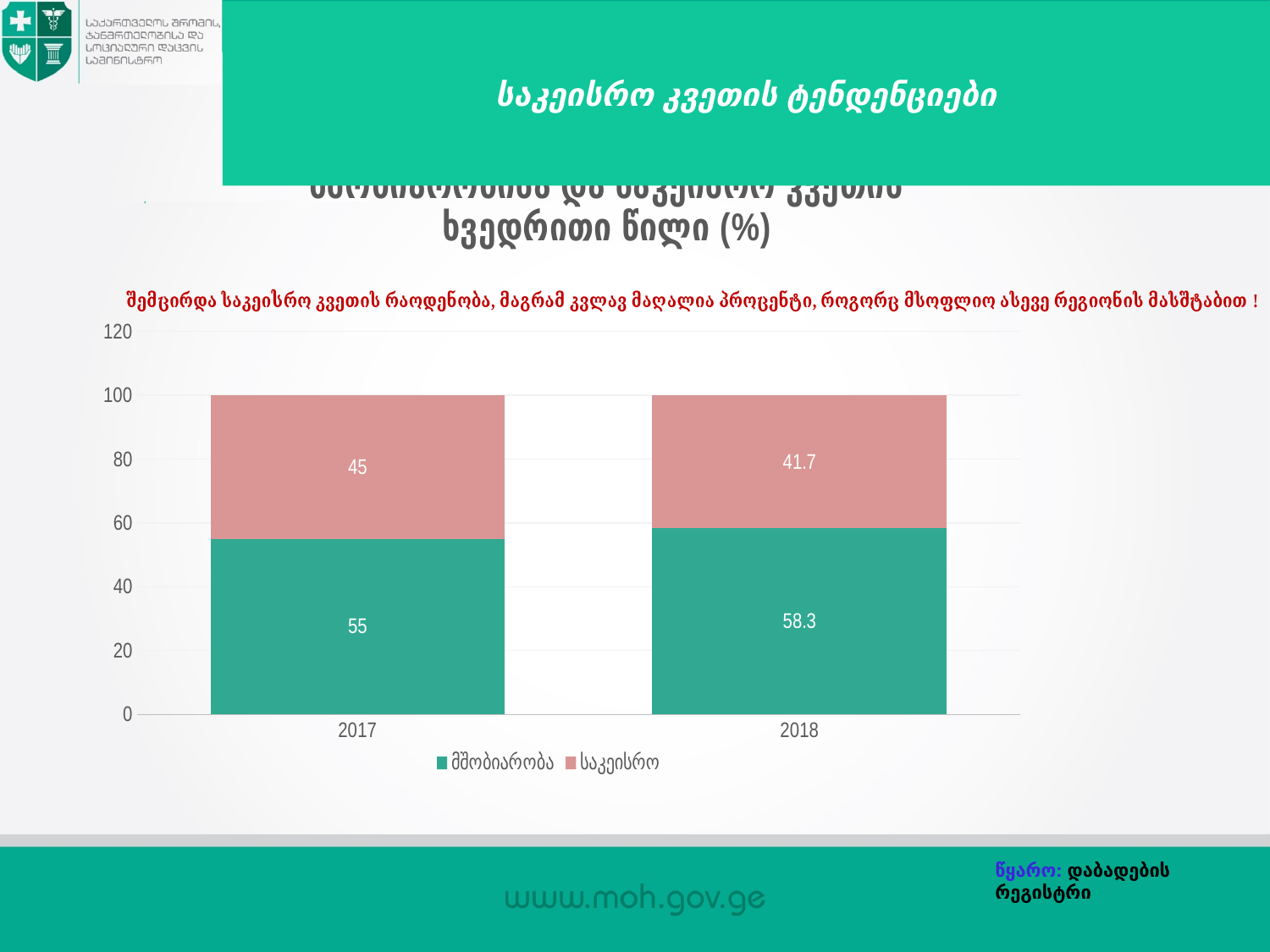
How many series does the legend list? 2 What kind of chart is shown on the slide? Stacked bar chart How many years are shown on the x axis? 2 In which year is the საკეისრო value higher? 2017 What is the value for საკეისრო in 2018? 41.7 What is the difference between the საკეისრო values for 2017 and 2018? 3.3 In which year is the მშობიარობა value lower? 2017 What is the value for მშობიარობა in 2018? 58.3 What is the value for საკეისრო in 2017? 45 What is the value for მშობიარობა in 2017? 55 Which is larger in 2018, მშობიარობა or საკეისრო? მშობიარობა What is the total of the stacked bar for 2018? 100